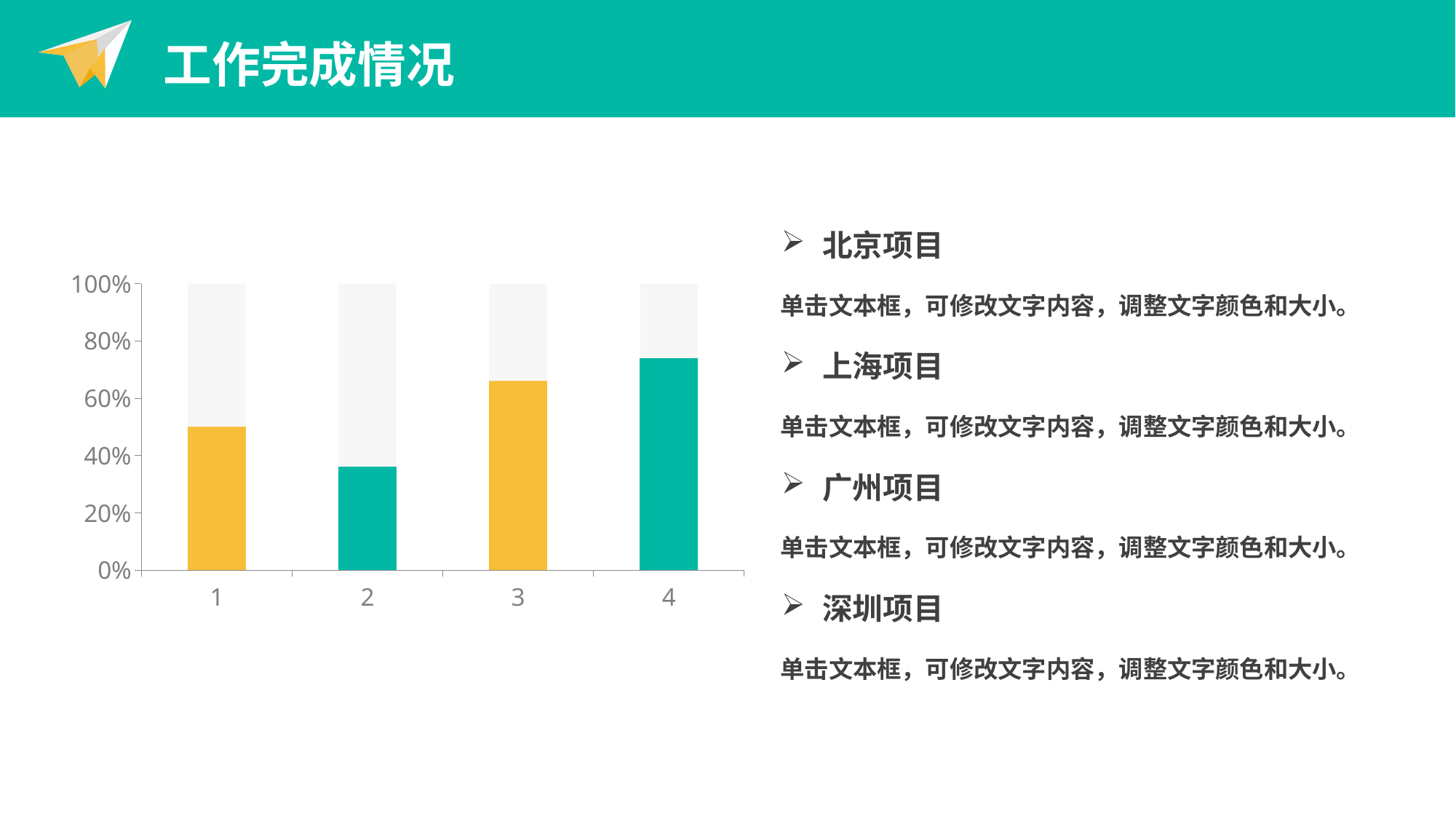
What is the title of the slide containing the chart? 工作完成情况 Which is larger, the value for category 3 or the value for category 1? 3 Is the value for category 3 greater or less than 60%? greater Is the value for category 4 greater or less than 80%? less Which category has the highest bar in the chart? 4 Which category has the lowest bar in the chart? 2 Which is larger, the value for category 2 or the value for category 4? 4 How many categories are shown on the x axis of the chart? 4 What kind of chart is shown on the slide? bar chart Is the value for category 1 greater or less than 40%? greater What colour are the bars for categories 2 and 4 in the chart? green